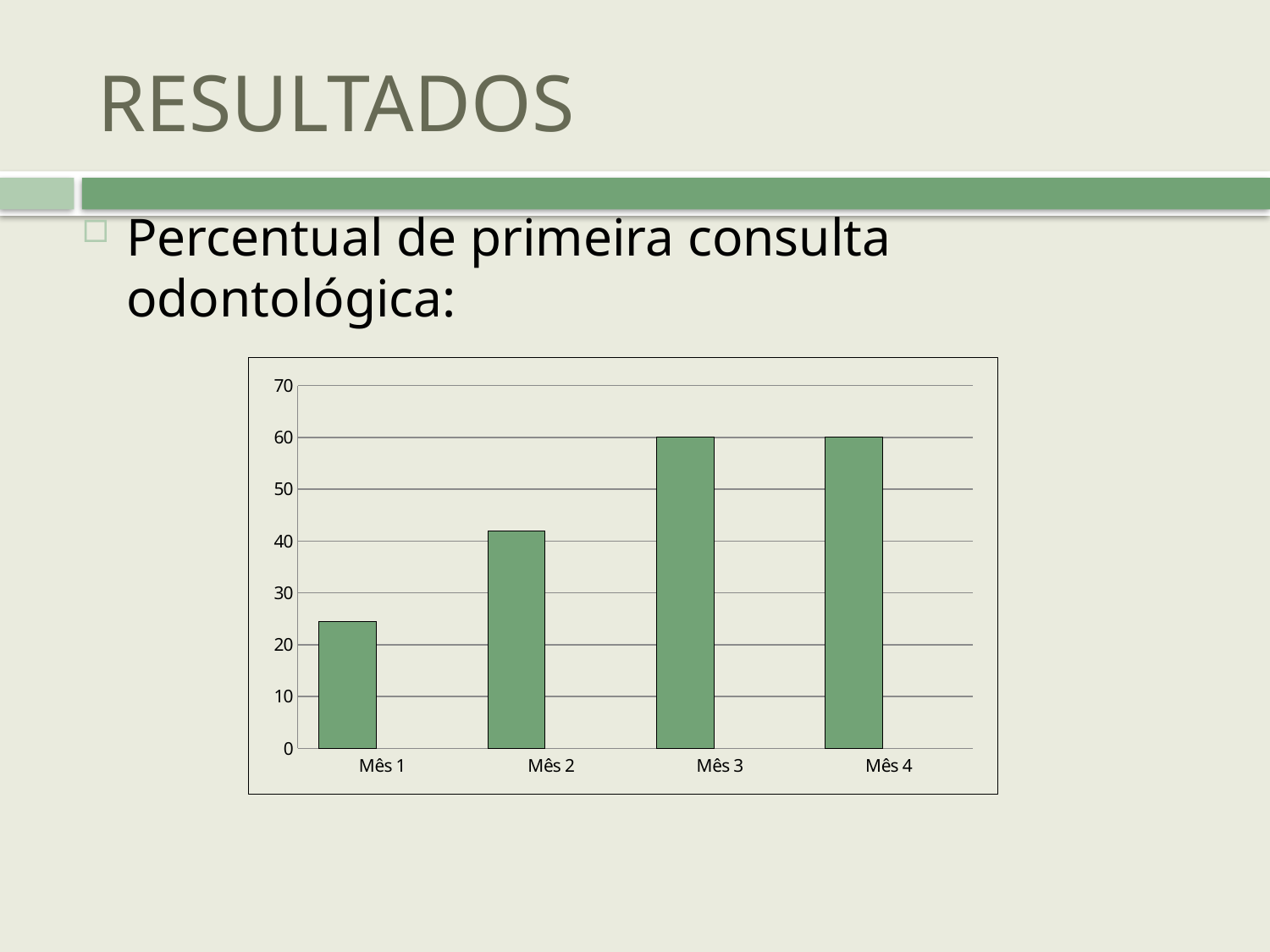
How many categories (months) are shown on the x axis of the chart? 4 What is the value for Mês 3 in the chart? 60 What is the highest value shown on the y axis of the chart? 70 What is the value for Mês 4 in the chart? 60 Do the values generally rise or fall from Mês 1 to Mês 4? rise Is the value for Mês 1 greater or less than 30? less Is the value for Mês 2 greater or less than 40? greater Which month has the lowest value in the chart? Mês 1 What kind of chart is shown on the slide? bar chart Which is larger, the value for Mês 2 or the value for Mês 3? Mês 3 Which is larger, the value for Mês 1 or the value for Mês 2? Mês 2 Is the value for Mês 1 greater or less than 20? greater